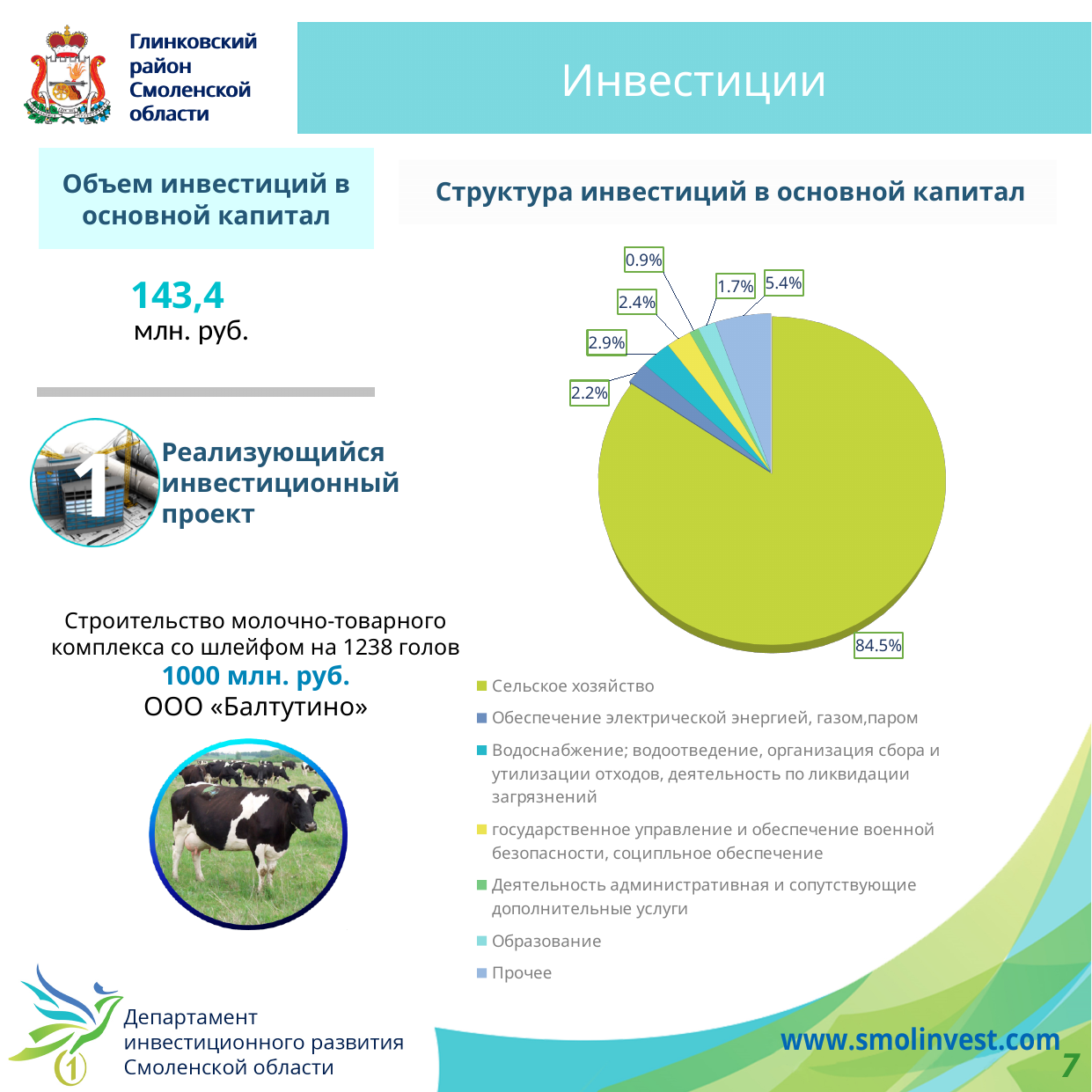
What is the value shown for "Образование" in the pie chart? 1.7% What is the value shown for "Прочее" in the pie chart? 5.4% What share of the pie chart does "Сельское хозяйство" account for? 84.5% Which category has the smallest slice in the pie chart? Деятельность административная и сопутствующие дополнительные услуги What is the value shown for "Обеспечение электрической энергией, газом,паром" in the pie chart? 2.2% What is the title of the pie chart? Структура инвестиций в основной капитал Which category has the largest slice in the pie chart? Сельское хозяйство What kind of chart is shown under the title "Структура инвестиций в основной капитал"? pie chart What is the difference in percentage points between the "Прочее" slice and the "Образование" slice? 3.7 Which slice is larger: "Водоснабжение; водоотведение..." or "государственное управление и обеспечение военной безопасности, социальное обеспечение"? Водоснабжение; водоотведение, организация сбора и утилизации отходов, деятельность по ликвидации загрязнений How many categories does the legend of the pie chart list? 7 What is the value shown for "Водоснабжение; водоотведение, организация сбора и утилизации отходов, деятельность по ликвидации загрязнений" in the pie chart? 2.9%